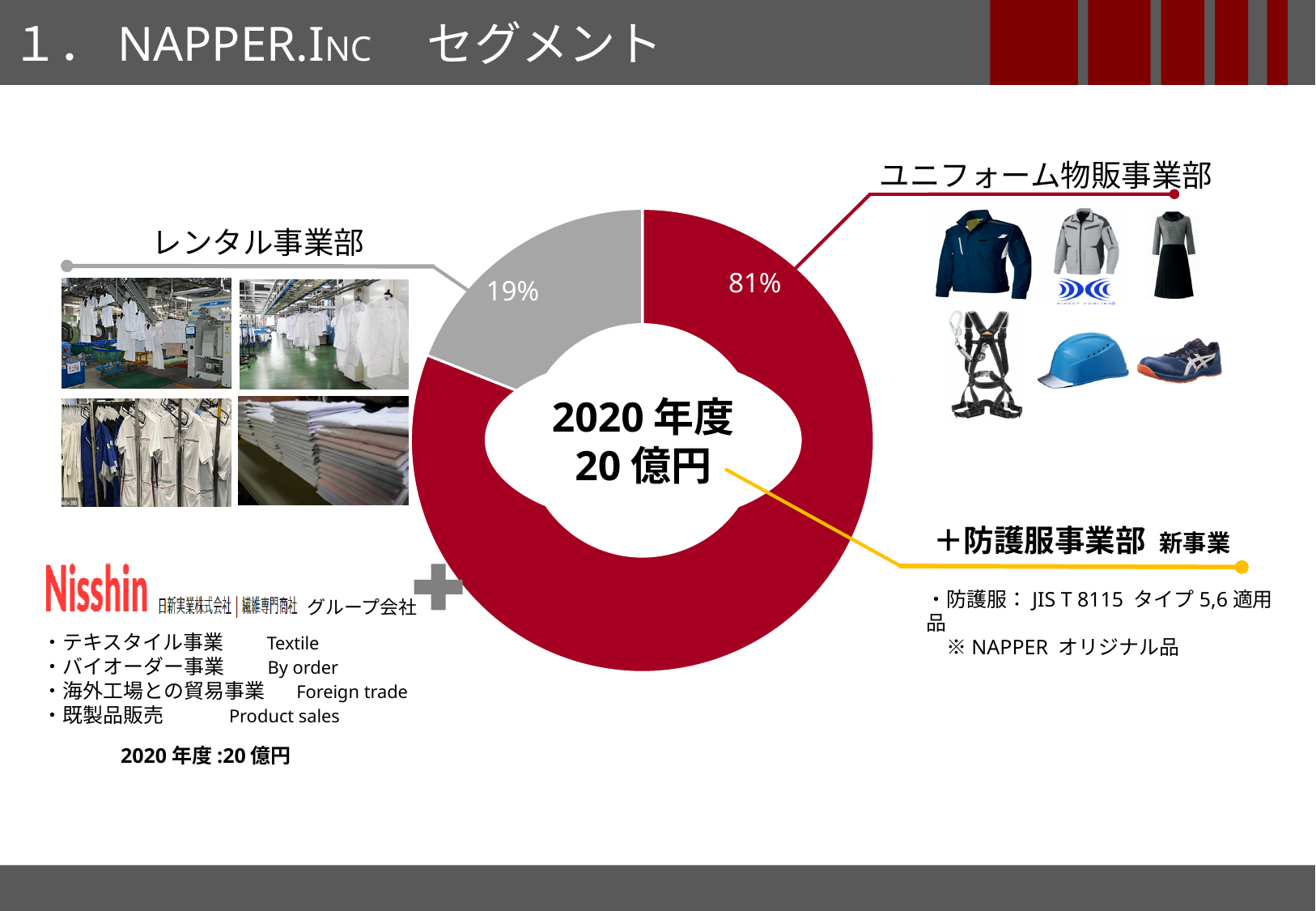
What colour is the ユニフォーム物販事業部 slice of the donut chart? Red What share of the donut chart does the ユニフォーム物販事業部 slice represent? 81% What text is shown in the centre of the donut chart? 2020年度 20億円 Which slice is larger, ユニフォーム物販事業部 or レンタル事業部? ユニフォーム物販事業部 Which segment has the largest slice in the donut chart? ユニフォーム物販事業部 Which segment has the smallest slice in the donut chart? レンタル事業部 What is the difference in percentage points between the ユニフォーム物販事業部 slice and the レンタル事業部 slice? 62 percentage points How many slices does the donut chart have? 2 What is the total of the two percentage slices shown in the donut chart? 100% What kind of chart is shown on the slide? Donut (pie) chart What share of the donut chart does the レンタル事業部 slice represent? 19%